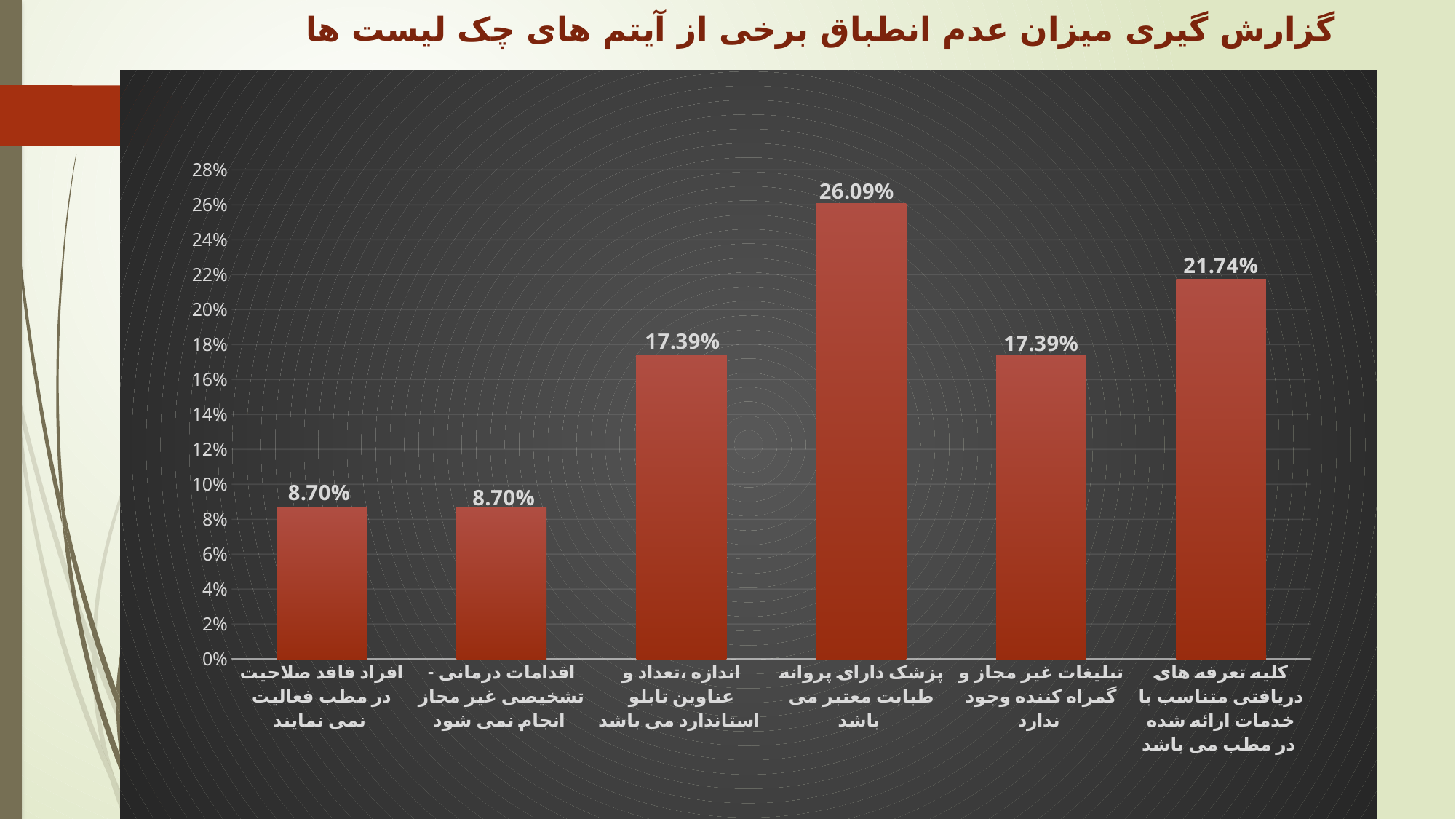
What is the value for the category "کلیه تعرفه های دریافتی متناسب با خدمات ارائه شده در مطب می باشد"? 21.74% Is the value for "کلیه تعرفه های دریافتی متناسب با خدمات ارائه شده در مطب می باشد" greater or less than 20%? greater What is the title of the slide containing the chart? گزارش گیری میزان عدم انطباق برخی از آیتم های چک لیست ها What is the difference between the value for "تبلیغات غیر مجاز و گمراه کننده وجود ندارد" and the value for "افراد فاقد صلاحیت در مطب فعالیت نمی نمایند"? 8.69% Which is larger: the value for "اندازه ،تعداد و عناوین تابلو استاندارد می باشد" or the value for "اقدامات درمانی - تشخیصی غیر مجاز انجام نمی شود"? اندازه ،تعداد و عناوین تابلو استاندارد می باشد What is the value for the category "تبلیغات غیر مجاز و گمراه کننده وجود ندارد"? 17.39% Which category has the highest value in the chart? پزشک دارای پروانه طبابت معتبر می باشد What is the value for the category "پزشک دارای پروانه طبابت معتبر می باشد"? 26.09% How many categories (bars) are plotted in the chart? 6 What is the difference between the value for "پزشک دارای پروانه طبابت معتبر می باشد" and the value for "کلیه تعرفه های دریافتی متناسب با خدمات ارائه شده در مطب می باشد"? 4.35% What is the value for the category "افراد فاقد صلاحیت در مطب فعالیت نمی نمایند"? 8.70% What type of chart is shown on the slide? bar chart